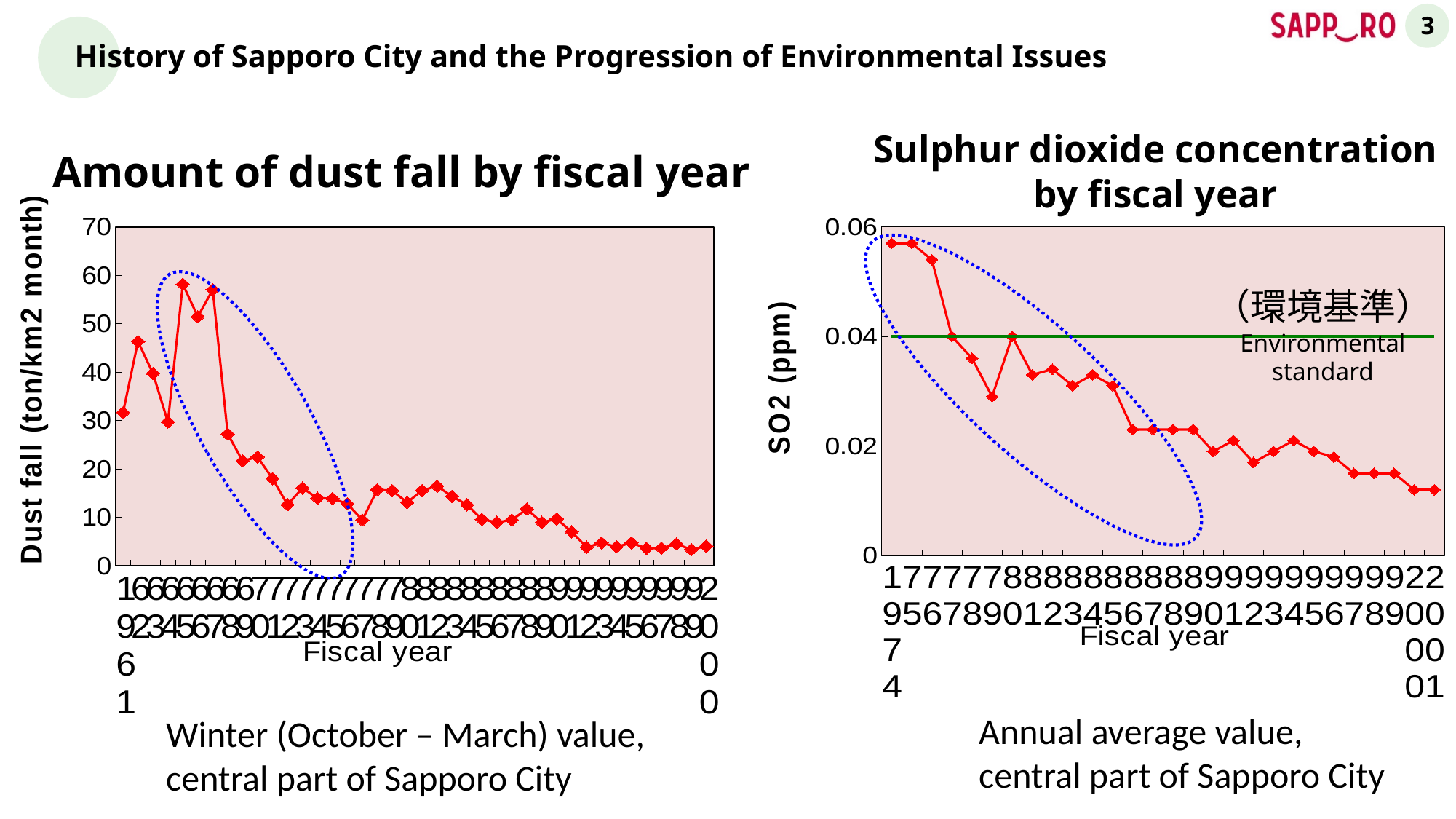
What kind of chart is the 'Amount of dust fall by fiscal year' chart? line chart In the 'Sulphur dioxide concentration by fiscal year' chart, which is larger: the value for fiscal year 1974 or the value for fiscal year 2001? 1974 What is the y-axis title of the 'Amount of dust fall by fiscal year' chart? Dust fall (ton/km2 month) What kind of chart is the 'Sulphur dioxide concentration by fiscal year' chart? line chart In the 'Sulphur dioxide concentration by fiscal year' chart, is the value for fiscal year 1974 greater or less than 0.04? greater In the 'Sulphur dioxide concentration by fiscal year' chart, do the values overall rise or fall across the fiscal years? fall In the 'Amount of dust fall by fiscal year' chart, is the highest plotted value greater or less than 50? greater In the 'Amount of dust fall by fiscal year' chart, which is larger: the value for fiscal year 1961 or the value for fiscal year 2000? 1961 In the 'Sulphur dioxide concentration by fiscal year' chart, at what SO2 level is the green 'Environmental standard' line drawn? 0.04 In the 'Amount of dust fall by fiscal year' chart, is the value for fiscal year 2000 greater or less than 10? less In the 'Amount of dust fall by fiscal year' chart, do the values overall rise or fall from the earliest to the latest fiscal year? fall